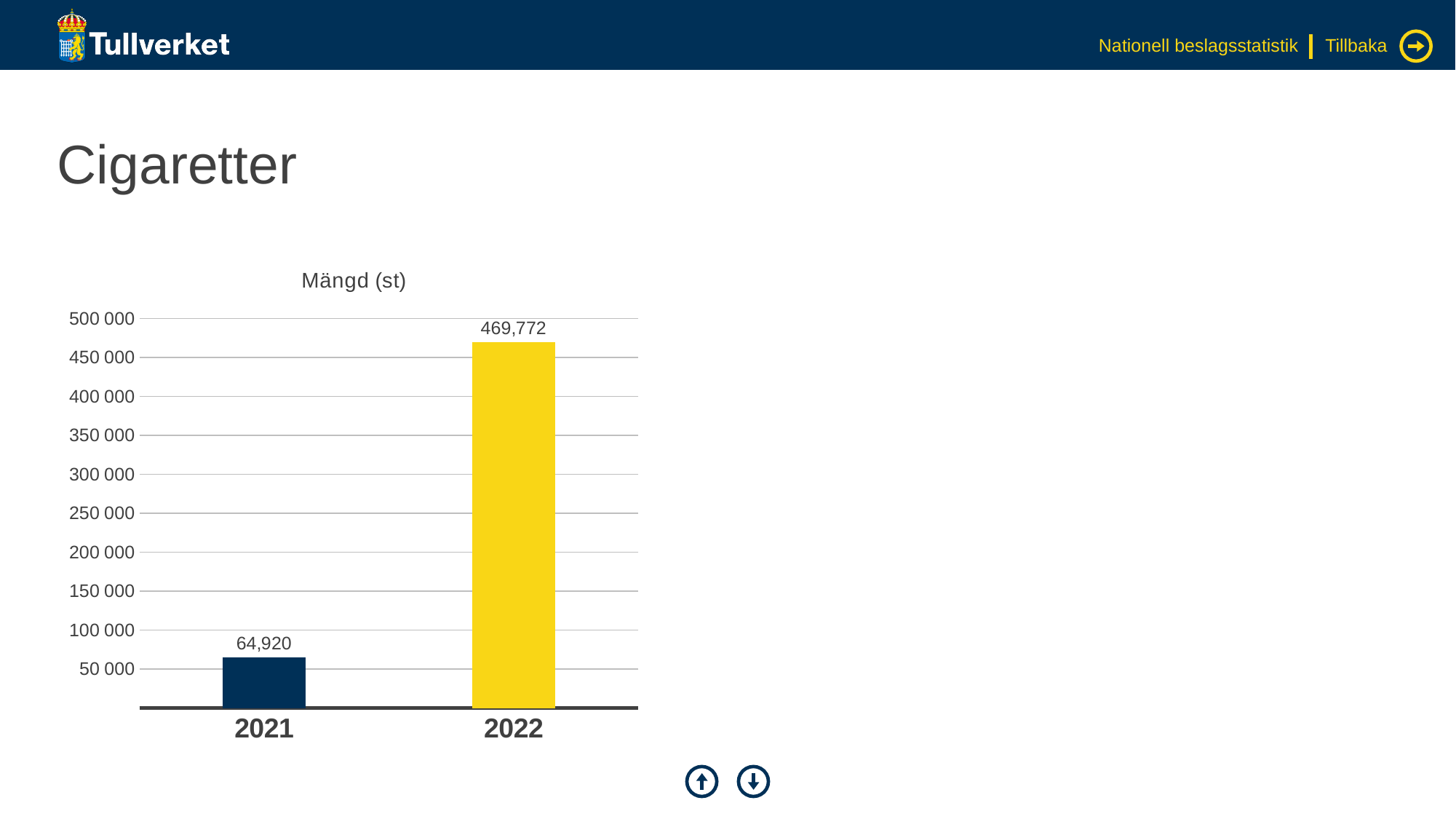
What is the difference between the values for 2022 and 2021? 404,852 Which is larger, the value for 2021 or the value for 2022? 2022 Which year has the highest value? 2022 How many years are shown on the x axis? 2 What is the value for 2021? 64,920 Which year has the lowest value? 2021 Do the values rise or fall from 2021 to 2022? rise Is the value for 2021 greater or less than 100 000? less Is the value for 2022 greater or less than 450 000? greater What is the title of the chart? Mängd (st) What is the value for 2022? 469,772 What kind of chart is shown on the slide? bar chart